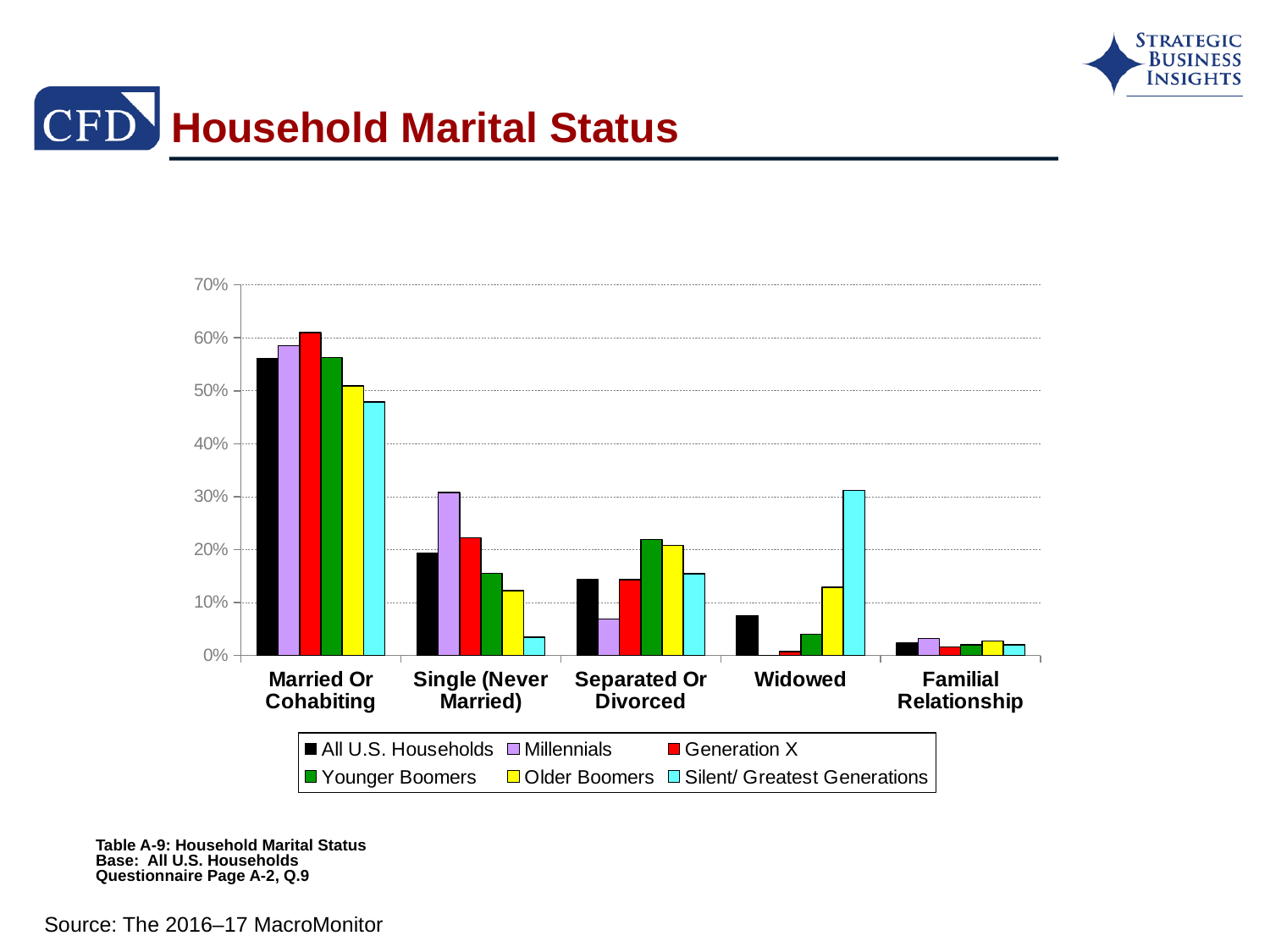
For Widowed, which is larger: Older Boomers or Younger Boomers? Older Boomers Is the value for Millennials in the Separated Or Divorced category greater or less than 10%? less Which series has the highest value for Married Or Cohabiting? Generation X Which series has the lowest value for Single (Never Married)? Silent/ Greatest Generations What kind of chart is shown on the slide? bar chart Which series has the highest value for Widowed? Silent/ Greatest Generations How many marital status categories are shown on the x axis? 5 Which series has the highest value for Single (Never Married)? Millennials How many series does the legend list? 6 Is the value for Silent/ Greatest Generations in the Widowed category greater or less than 20%? greater For Married Or Cohabiting, which is larger: Millennials or Silent/ Greatest Generations? Millennials Is the value for Older Boomers in the Married Or Cohabiting category greater or less than 60%? less